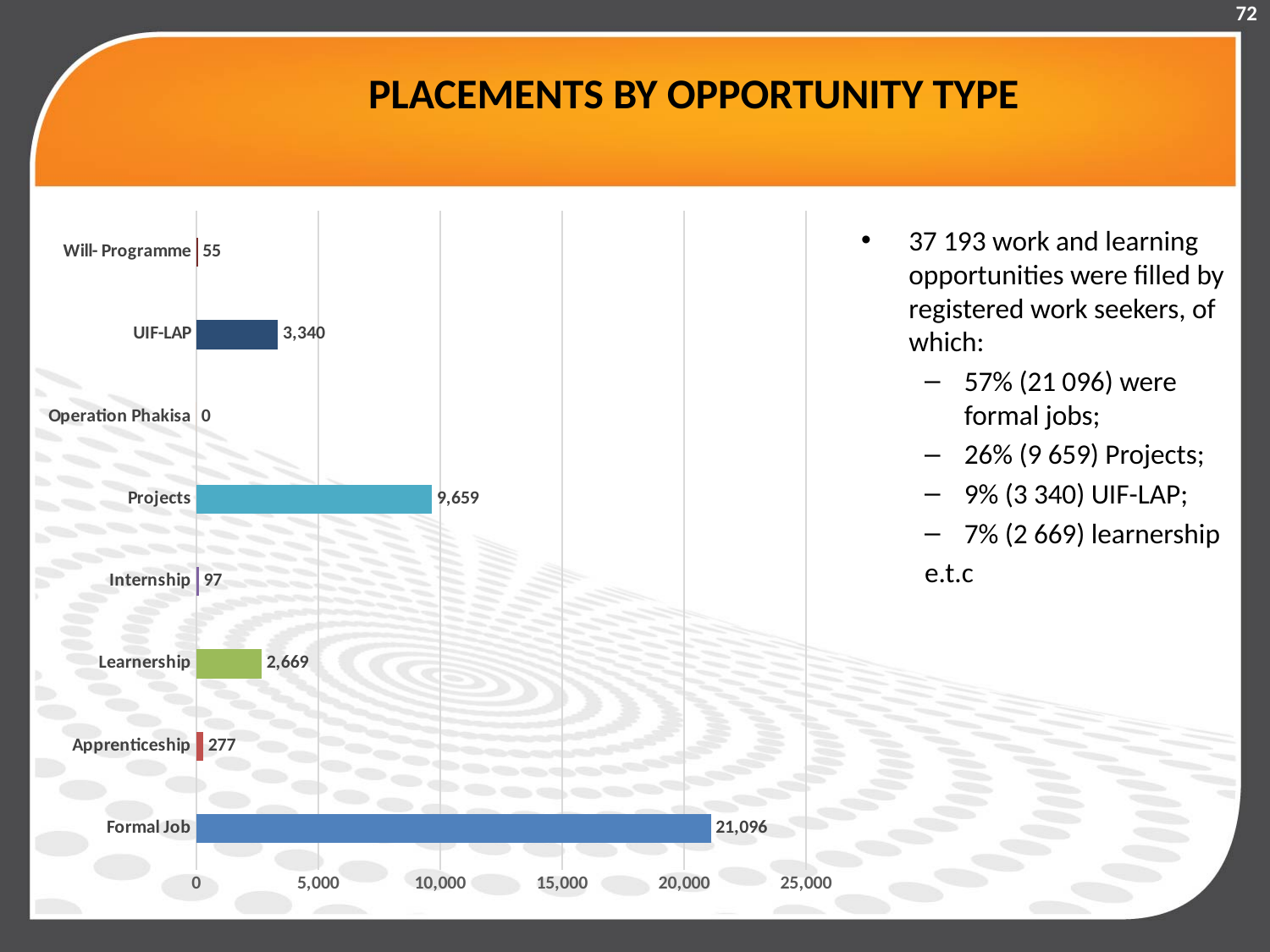
Is the value for Formal Job greater or less than 20,000? greater What is the value for Internship? 97 What is the value for UIF-LAP? 3,340 Which is larger, the value for Learnership or the value for UIF-LAP? UIF-LAP What is the value for Formal Job? 21,096 How many categories are shown in the chart? 8 What is the difference between the values for Formal Job and Projects? 11,437 What kind of chart is shown on the slide? bar chart Which category has the highest value? Formal Job Which category has the lowest value? Operation Phakisa What is the title of the slide containing the chart? PLACEMENTS BY OPPORTUNITY TYPE What is the value for Projects? 9,659